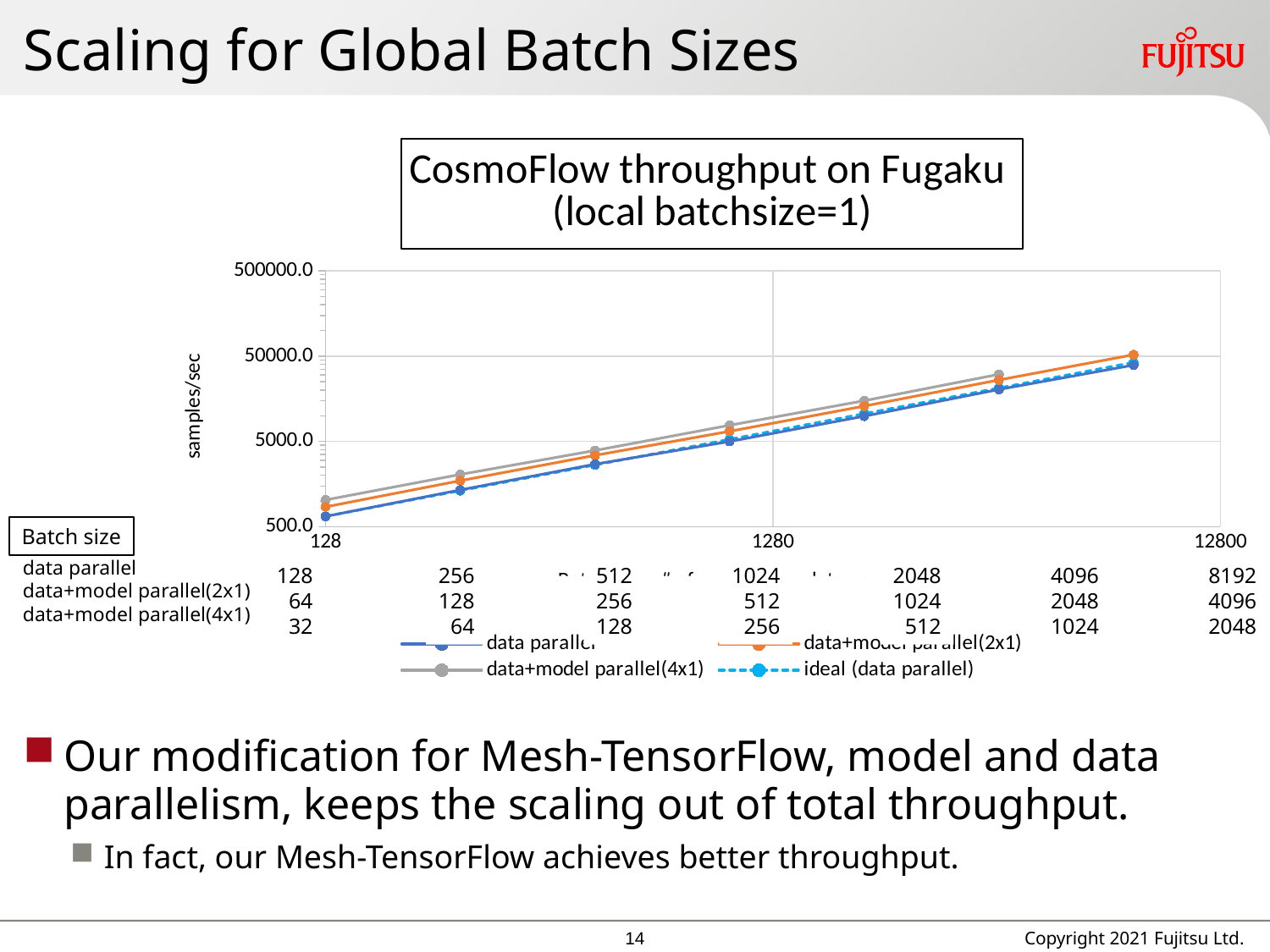
Which series has the highest throughput at the smallest batch size (128)? data+model parallel(4x1) What kind of chart is shown on the slide? line chart Is the throughput of data+model parallel(2x1) at batch size 1024 greater or less than 5000.0 samples/sec? greater Is the throughput of data parallel at batch size 8192 greater or less than 50000.0 samples/sec? less Which series has the lowest throughput at batch size 128? data parallel and ideal (data parallel) (tied) Do the throughput values rise or fall as the batch size increases along the x axis? rise At batch size 1024, which is larger: the throughput of data+model parallel(4x1) or of data parallel? data+model parallel(4x1) Is the throughput of data+model parallel(4x1) at batch size 128 greater or less than 500.0 samples/sec? greater What is the label of the y axis? samples/sec How many series does the chart legend list? 4 How many data points are plotted for the data parallel series? 7 What is the title of the chart? CosmoFlow throughput on Fugaku (local batchsize=1)